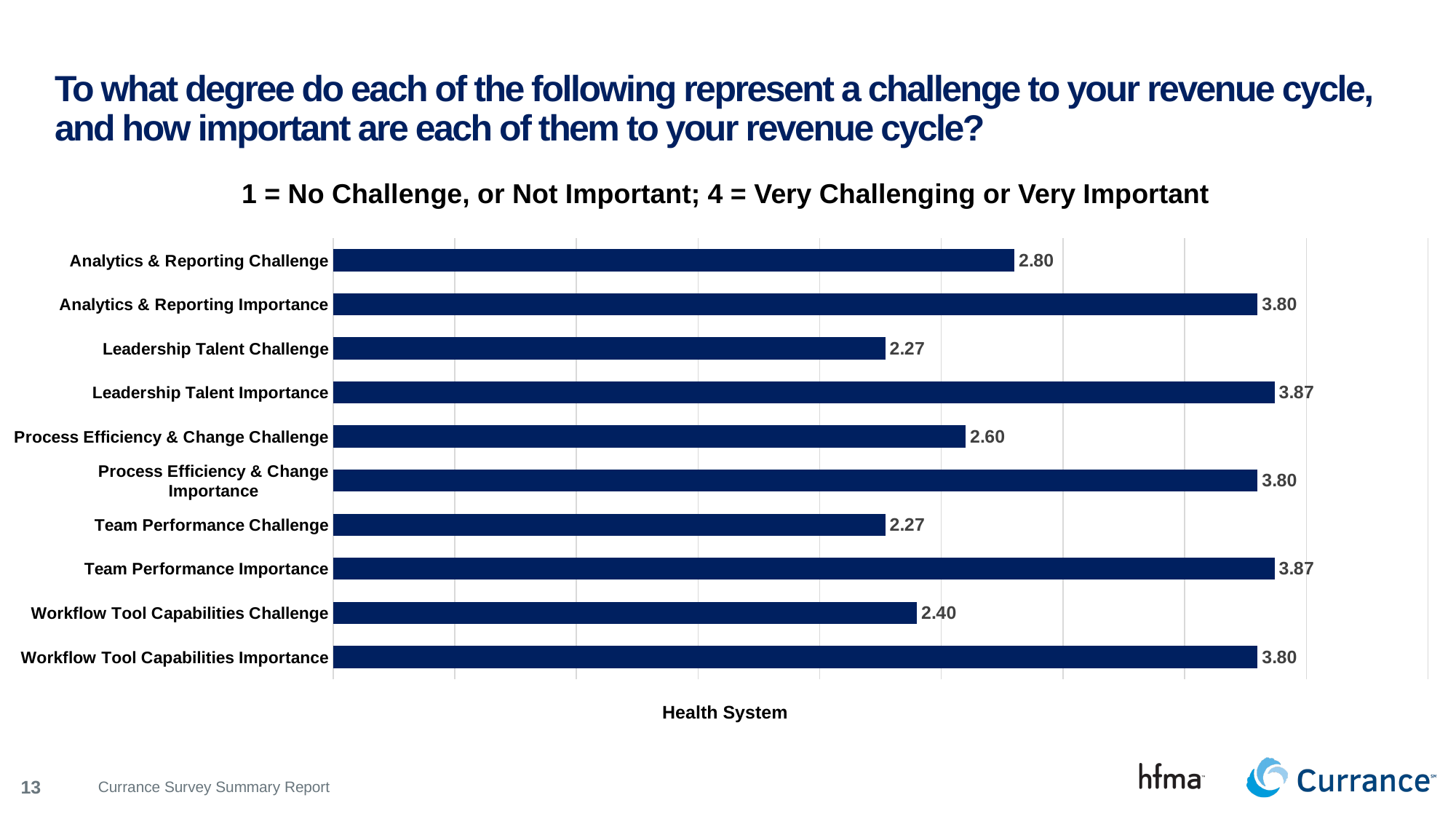
What is the value for Workflow Tool Capabilities Challenge? 2.40 What is the value for Leadership Talent Importance? 3.87 Which is larger, the value for Process Efficiency & Change Challenge or the value for Team Performance Challenge? Process Efficiency & Change Challenge What is the difference between Analytics & Reporting Importance and Analytics & Reporting Challenge? 1.00 What type of chart is shown on the slide? bar chart Which is larger, the value for Analytics & Reporting Challenge or the value for Workflow Tool Capabilities Challenge? Analytics & Reporting Challenge What is the value for Process Efficiency & Change Challenge? 2.60 What is the value for Team Performance Challenge? 2.27 What is the value for Analytics & Reporting Challenge? 2.80 What label appears below the chart's horizontal axis? Health System How many categories are plotted in the chart? 10 What is the difference between Leadership Talent Importance and Leadership Talent Challenge? 1.60